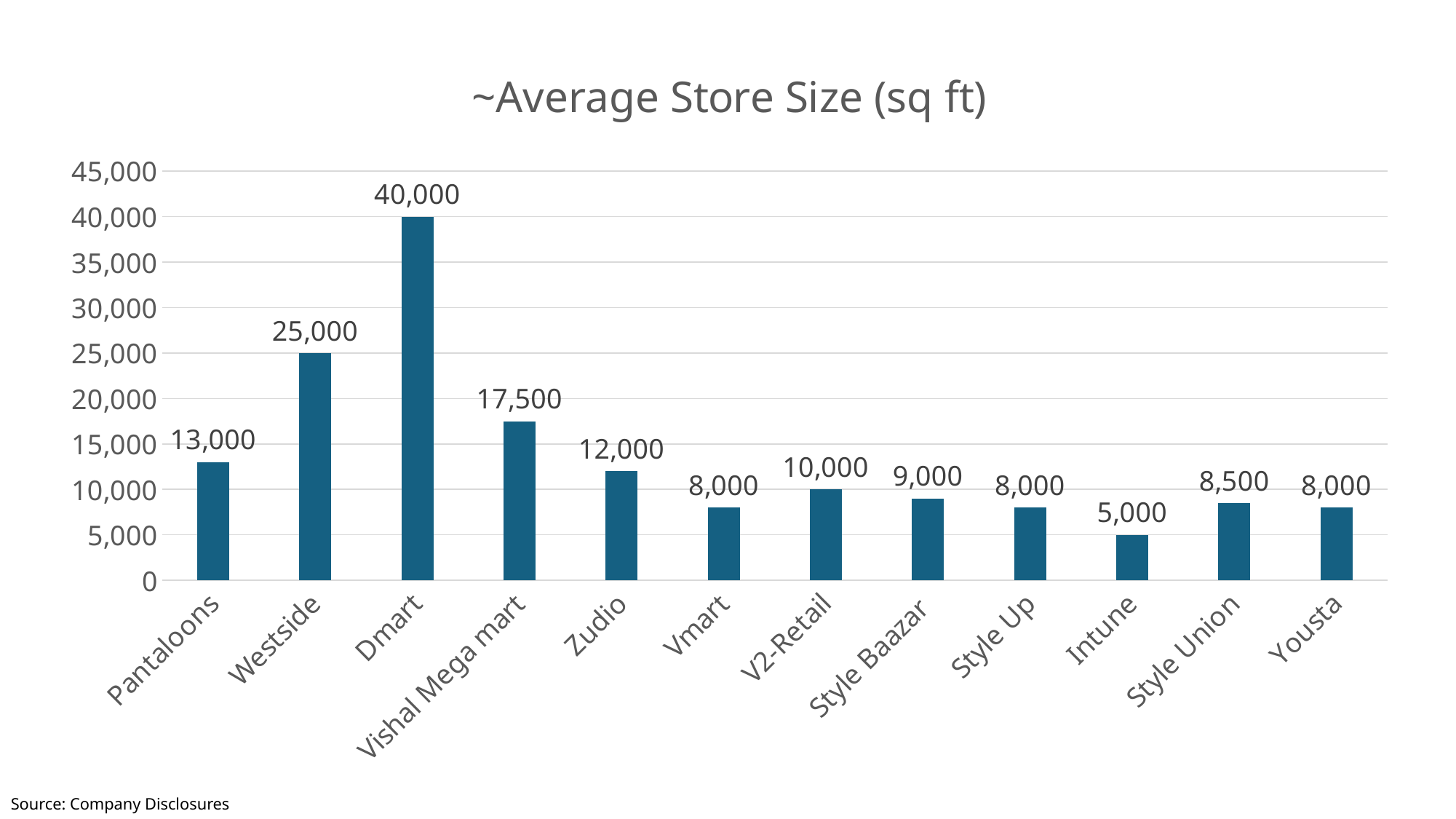
What is the average store size for Vishal Mega mart? 17,500 Which retailer has the largest average store size? Dmart What is the average store size for Style Union? 8,500 How many retailers are shown on the chart? 12 What kind of chart is shown on the slide? Bar chart Is the average store size for Westside greater or less than 20,000? greater What is the average store size for Dmart? 40,000 What is the title of the chart? ~Average Store Size (sq ft) Which has a larger average store size, V2-Retail or Style Baazar? V2-Retail What is the difference between the average store sizes of Pantaloons and Zudio? 1,000 Which retailer has the smallest average store size? Intune What is the difference between the average store sizes of Dmart and Westside? 15,000